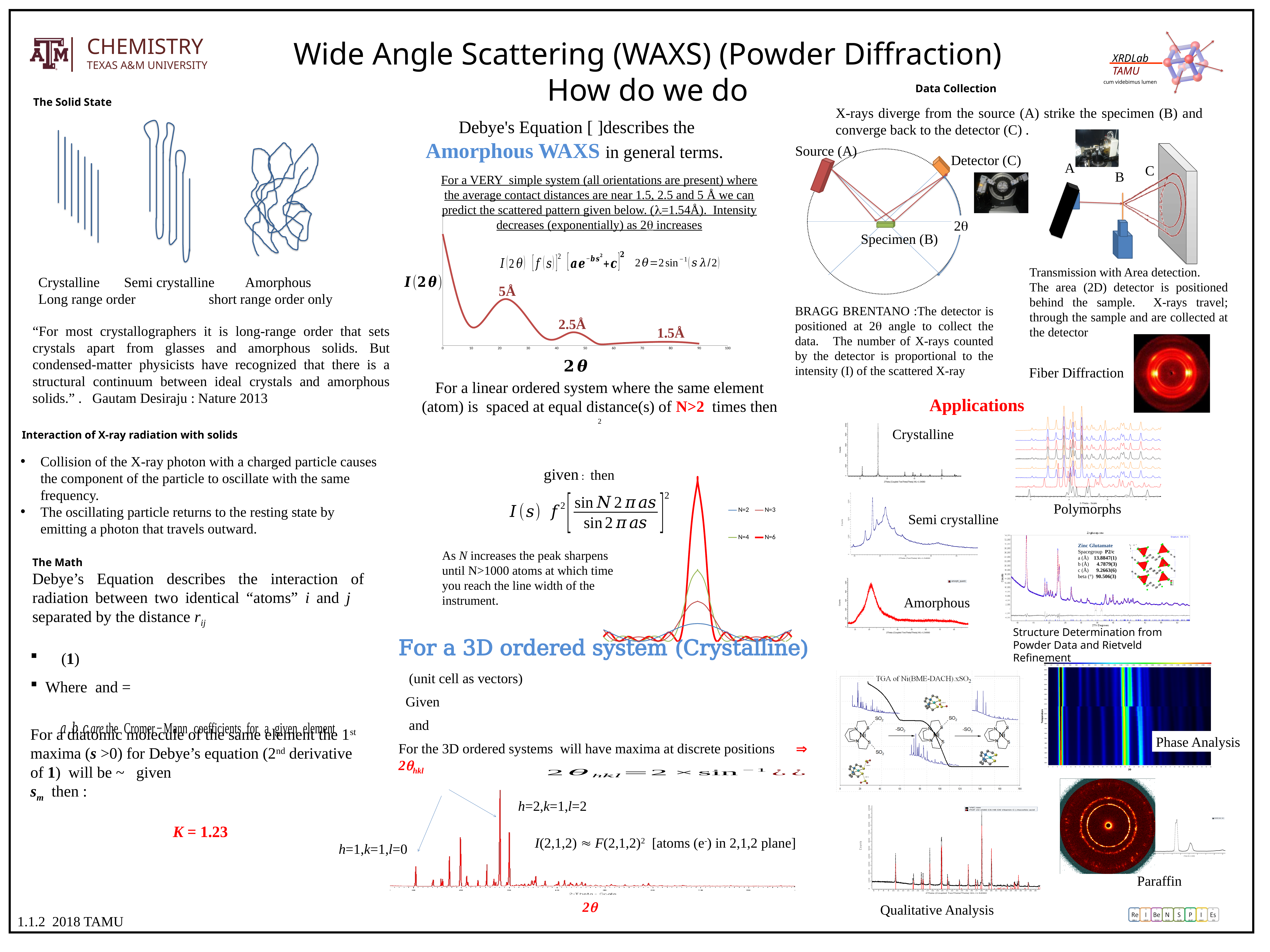
In the chart of peaks for different N values, which series has the tallest central peak? N=6 In the chart of peaks for different N values, which series has a taller central peak, N=4 or N=3? N=4 In the crystalline diffraction pattern at the bottom centre of the slide, which labelled reflection has the taller peak, h=1,k=1,l=0 or h=2,k=1,l=2? h=2,k=1,l=2 In the Amorphous WAXS chart of I(2θ) versus 2θ, which peak is higher, the 5Å peak or the 2.5Å peak? 5Å In the chart of peaks for different N values, which series has the lowest central peak? N=2 In the Amorphous WAXS chart of I(2θ) versus 2θ, which labelled peak has the lowest intensity? 1.5Å In the Amorphous WAXS chart of I(2θ) versus 2θ, how many peaks are labelled with a contact distance? 3 In the Amorphous WAXS chart of I(2θ) versus 2θ, does the intensity generally rise or fall as 2θ increases? Fall In the Amorphous WAXS chart of I(2θ) versus 2θ, which labelled peak has the highest intensity? 5Å In the Amorphous WAXS chart of I(2θ) versus 2θ, what is the largest tick value shown on the x axis? 100 In the chart of peaks for different N values (legend N=2, N=3, N=4, N=6), how many series does the legend list? 4 What kind of chart is the Amorphous WAXS plot of I(2θ) versus 2θ in the centre of the slide? Line chart